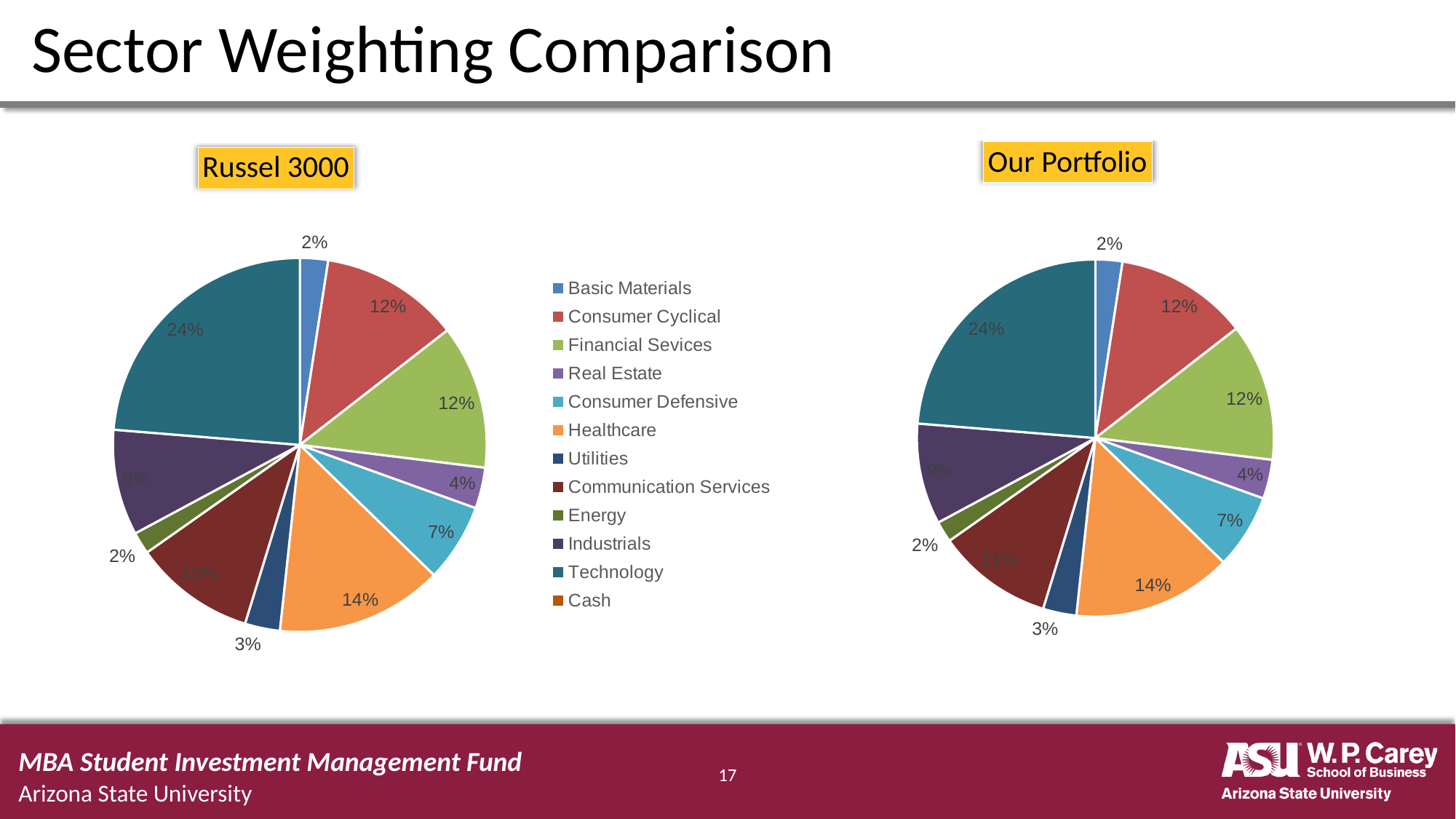
In the Russel 3000 chart, what share does Technology have? 24% How many entries does the legend list? 12 In the Our Portfolio chart, what share does Industrials have? 9% In the Our Portfolio chart, which is larger, Communication Services or Consumer Cyclical? Consumer Cyclical In the Russel 3000 chart, what share does Consumer Defensive have? 7% In the Russel 3000 chart, what share does Real Estate have? 4% In the Russel 3000 chart, what is the difference between the Technology share and the Healthcare share? 10% In the Russel 3000 chart, which sector has the largest slice? Technology What is the title of the pie chart on the right? Our Portfolio What type of charts are shown on the slide? Pie charts In the Our Portfolio chart, what share does Healthcare have? 14% In the Our Portfolio chart, what share does Utilities have? 3%